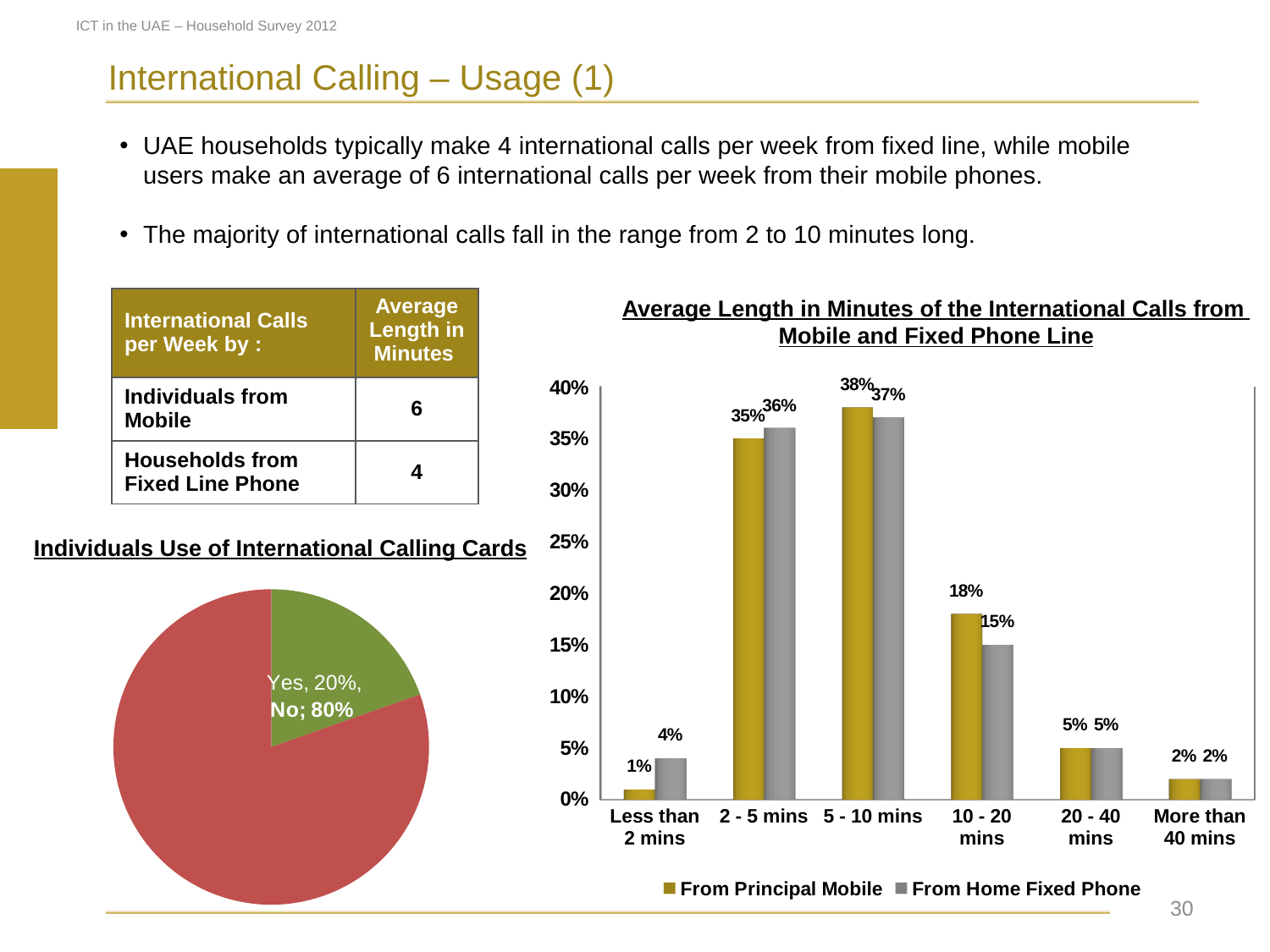
How many call length categories are shown on the x axis of the bar chart on the right? 6 In the bar chart on the right, which call length category has the highest value for From Principal Mobile? 5 - 10 mins In the bar chart on the right, what is the difference between the From Principal Mobile and From Home Fixed Phone values for 10 - 20 mins? 3% In the bar chart on the right, what is the value for From Home Fixed Phone in the 10 - 20 mins category? 15% How many series does the legend of the bar chart on the right list? 2 In the pie chart 'Individuals Use of International Calling Cards', what is the value for Yes? 20% In the bar chart on the right, what percentage of international calls from the home fixed phone are less than 2 mins long? 4% In the bar chart on the right, which is larger for the Less than 2 mins category: From Principal Mobile or From Home Fixed Phone? From Home Fixed Phone In the bar chart on the right, which call length category has the lowest value for From Principal Mobile? Less than 2 mins What kind of chart is the chart titled 'Individuals Use of International Calling Cards'? Pie chart In the bar chart on the right, what percentage of international calls from the principal mobile are 5 - 10 mins long? 38% In the pie chart 'Individuals Use of International Calling Cards', what share of individuals answered No? 80%